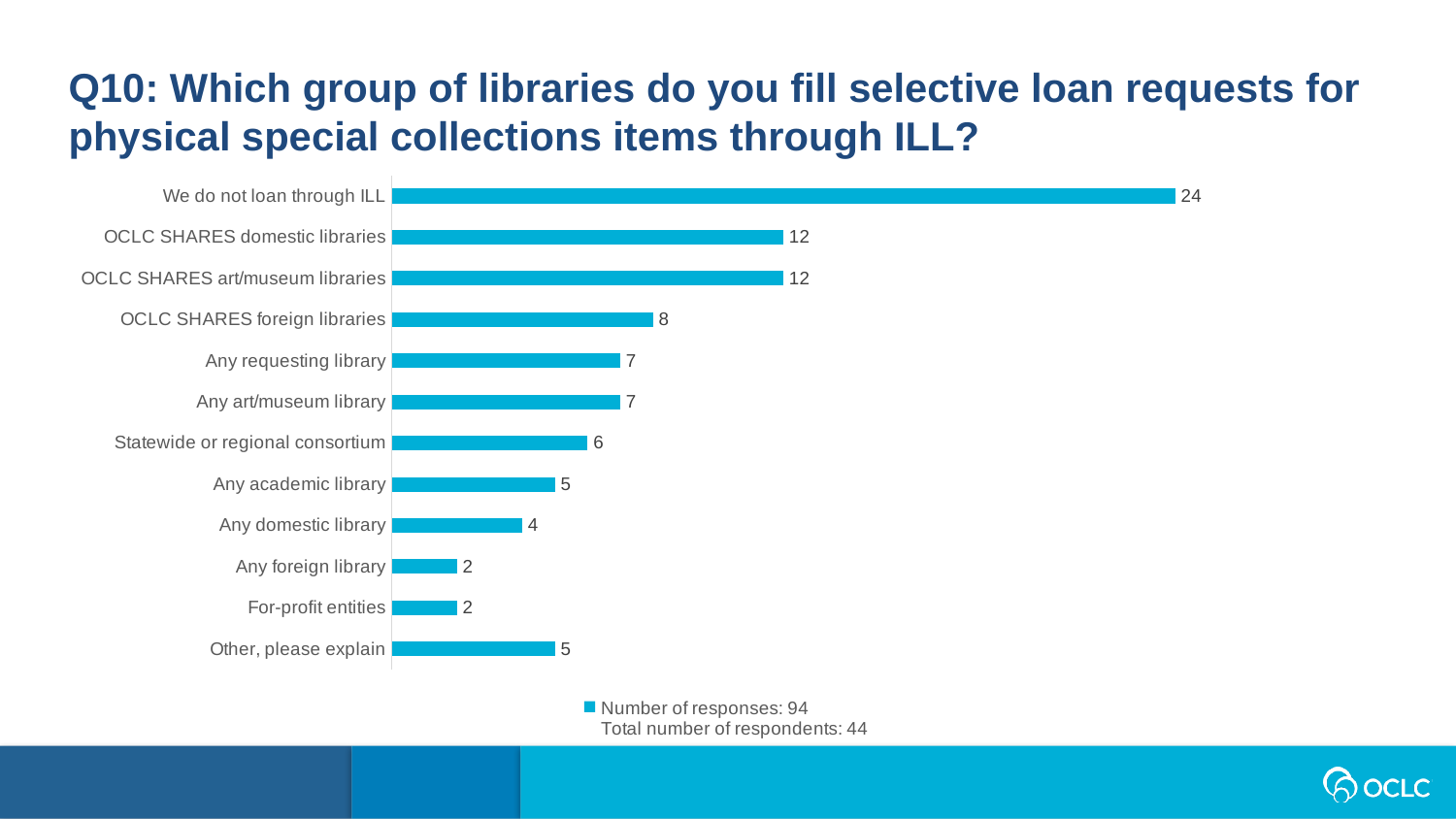
What is the value for 'Statewide or regional consortium'? 6 What is the difference between 'OCLC SHARES foreign libraries' and 'Any academic library'? 3 Which is larger: 'Any requesting library' or 'Any academic library'? Any requesting library Which category has the highest value? We do not loan through ILL How many series does the legend list? 1 How many categories are shown in the chart? 12 What is the value for 'OCLC SHARES foreign libraries'? 8 What is the total number of respondents stated below the chart? 44 What kind of chart is shown on the slide? Bar chart What is the difference between 'We do not loan through ILL' and 'OCLC SHARES domestic libraries'? 12 What is the value for 'Any domestic library'? 4 What is the value for 'We do not loan through ILL'? 24